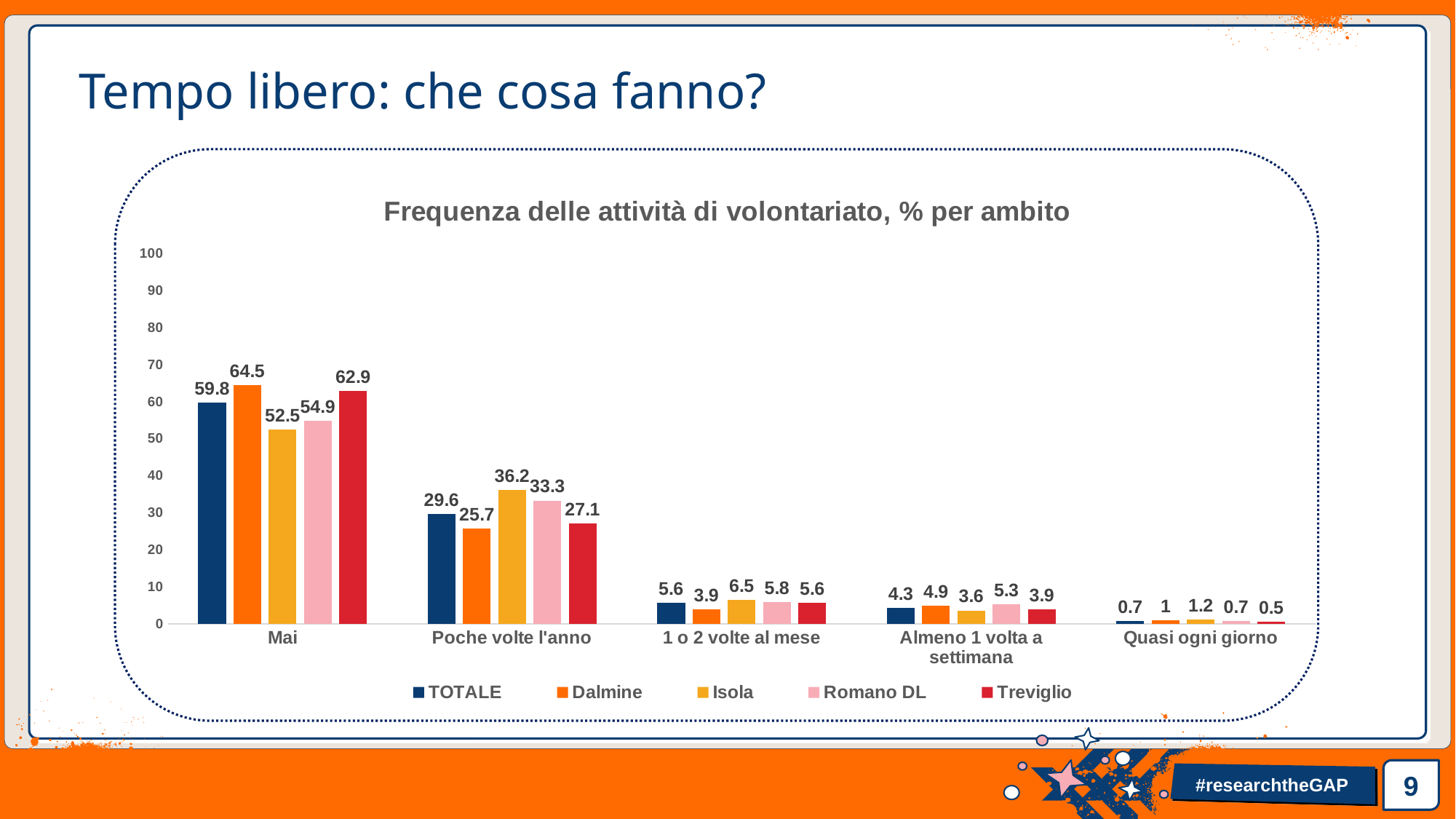
What is the difference between the Treviglio and Isola values in the "Mai" category? 10.4 How many series does the legend list? 5 Is the Romano DL value for "Poche volte l'anno" greater or less than 30? greater How many categories are shown on the x axis? 5 What kind of chart is shown on the slide? Bar chart What is the TOTALE value for "Quasi ogni giorno"? 0.7 What is the title of the chart? Frequenza delle attività di volontariato, % per ambito Which series has the highest value in the "Mai" category? Dalmine What is the value for Isola in the "Poche volte l'anno" category? 36.2 Which series has the lowest value in the "Almeno 1 volta a settimana" category? Isola What is the value for Dalmine in the "Mai" category? 64.5 In the "1 o 2 volte al mese" category, which is larger: Isola or Dalmine? Isola